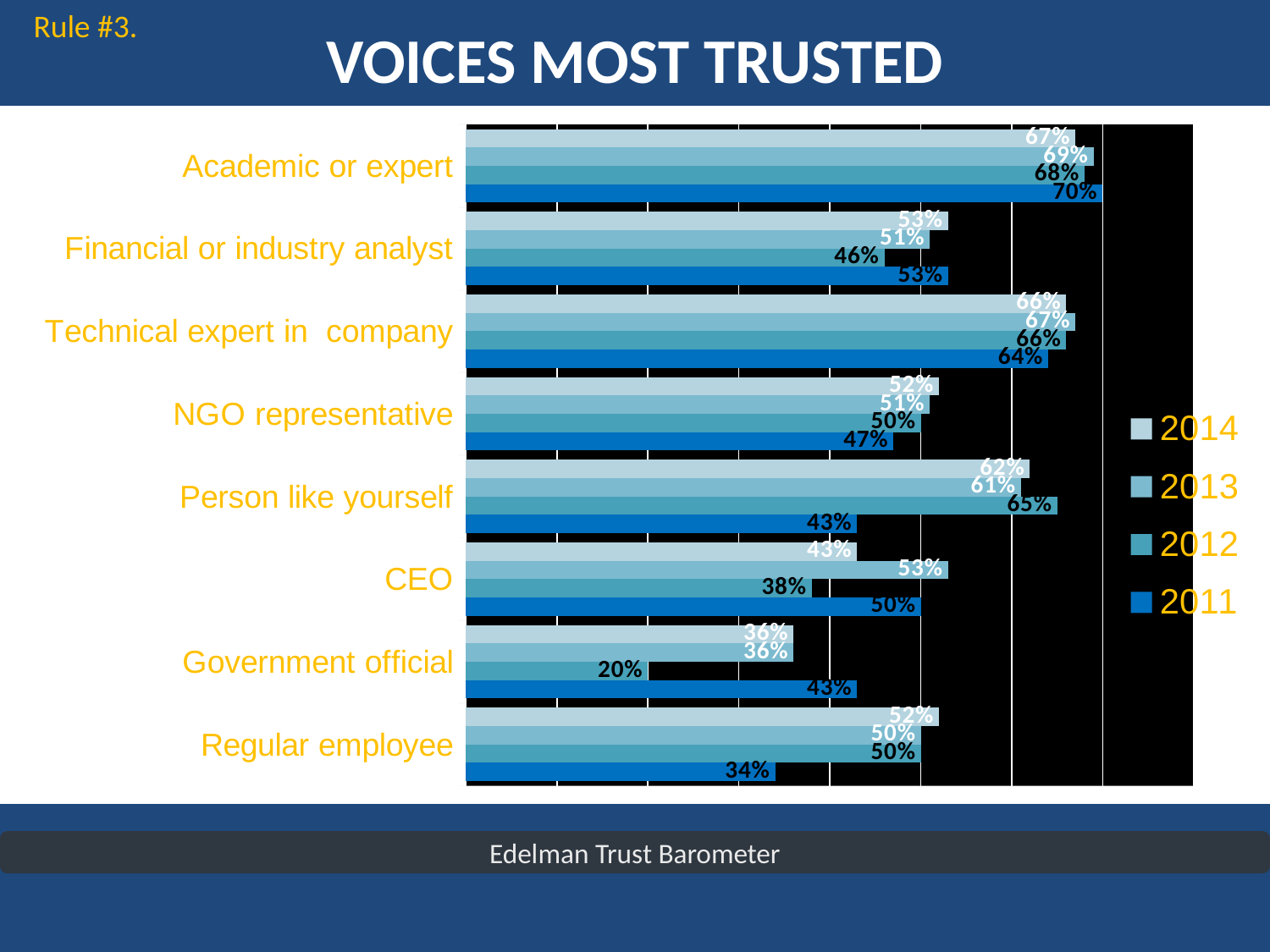
For CEO, which is larger: the 2013 value or the 2012 value? 2013 Which category has the lowest 2012 value? Government official What is the 2012 value for Government official? 20% How many categories are plotted on the chart? 8 What is the 2011 value for Regular employee? 34% What is the 2011 value for Academic or expert? 70% How many series does the legend list? 4 What is the title of the chart? VOICES MOST TRUSTED What is the 2012 value for Person like yourself? 65% What is the difference between the 2011 and 2012 values for Government official? 23 percentage points What kind of chart is shown on the slide? Bar chart Which category has the highest 2011 value? Academic or expert